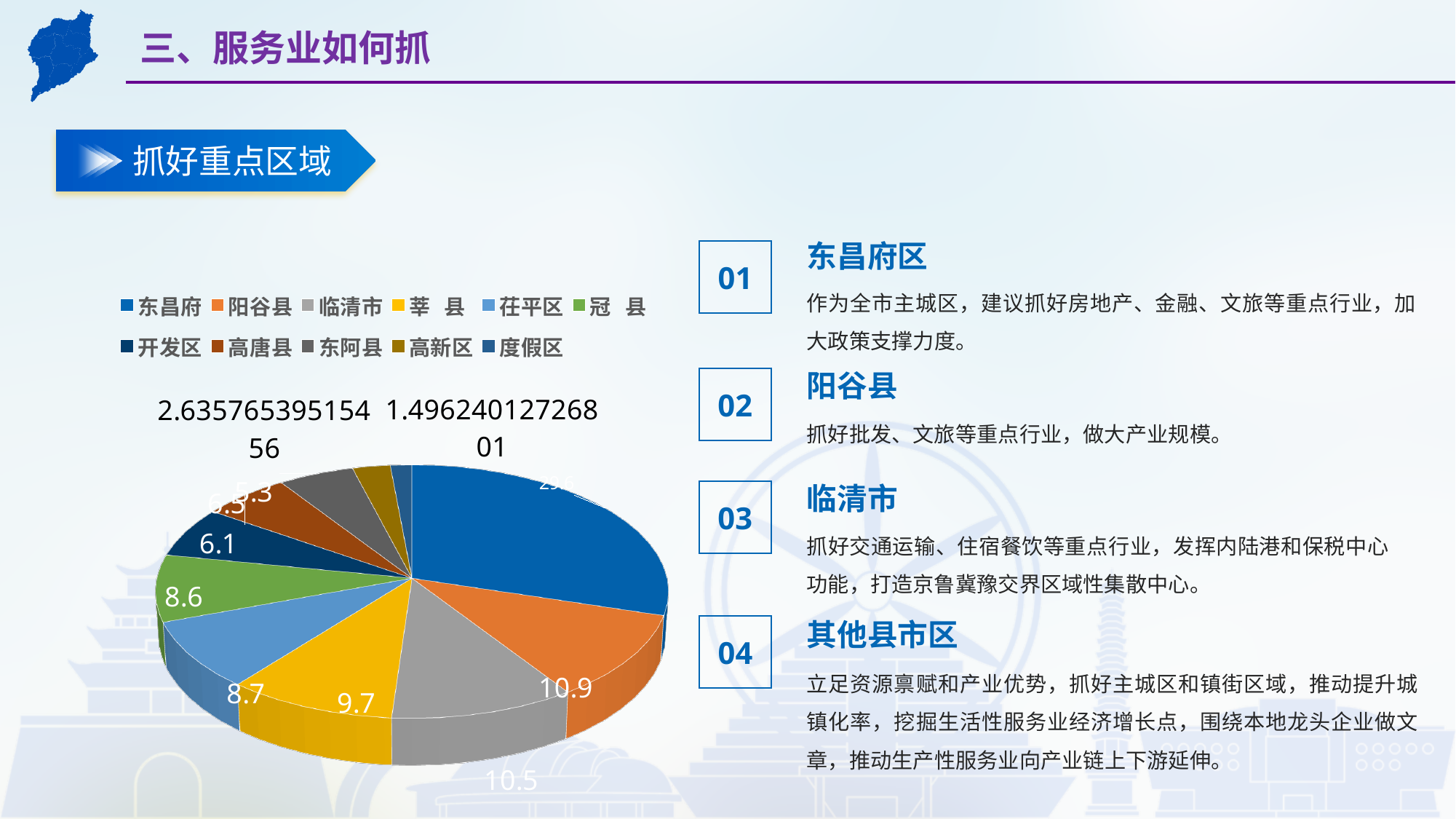
What is the value shown for 临清市 in the pie chart? 10.5 What is the value shown for 冠县 in the pie chart? 8.6 Which category has the largest slice in the pie chart? 东昌府 What is the value shown for 莘县 in the pie chart? 9.7 Which has the larger value in the pie chart, 莘县 or 茌平区? 莘县 What is the difference between the values for 阳谷县 and 临清市 in the pie chart? 0.4 Which category has the smallest slice in the pie chart? 度假区 What kind of chart is shown on the slide? pie chart How many categories does the legend of the pie chart list? 11 What is the value shown for 开发区 in the pie chart? 6.5 What is the value shown for 阳谷县 in the pie chart? 10.9 What is the value shown for 茌平区 in the pie chart? 8.7